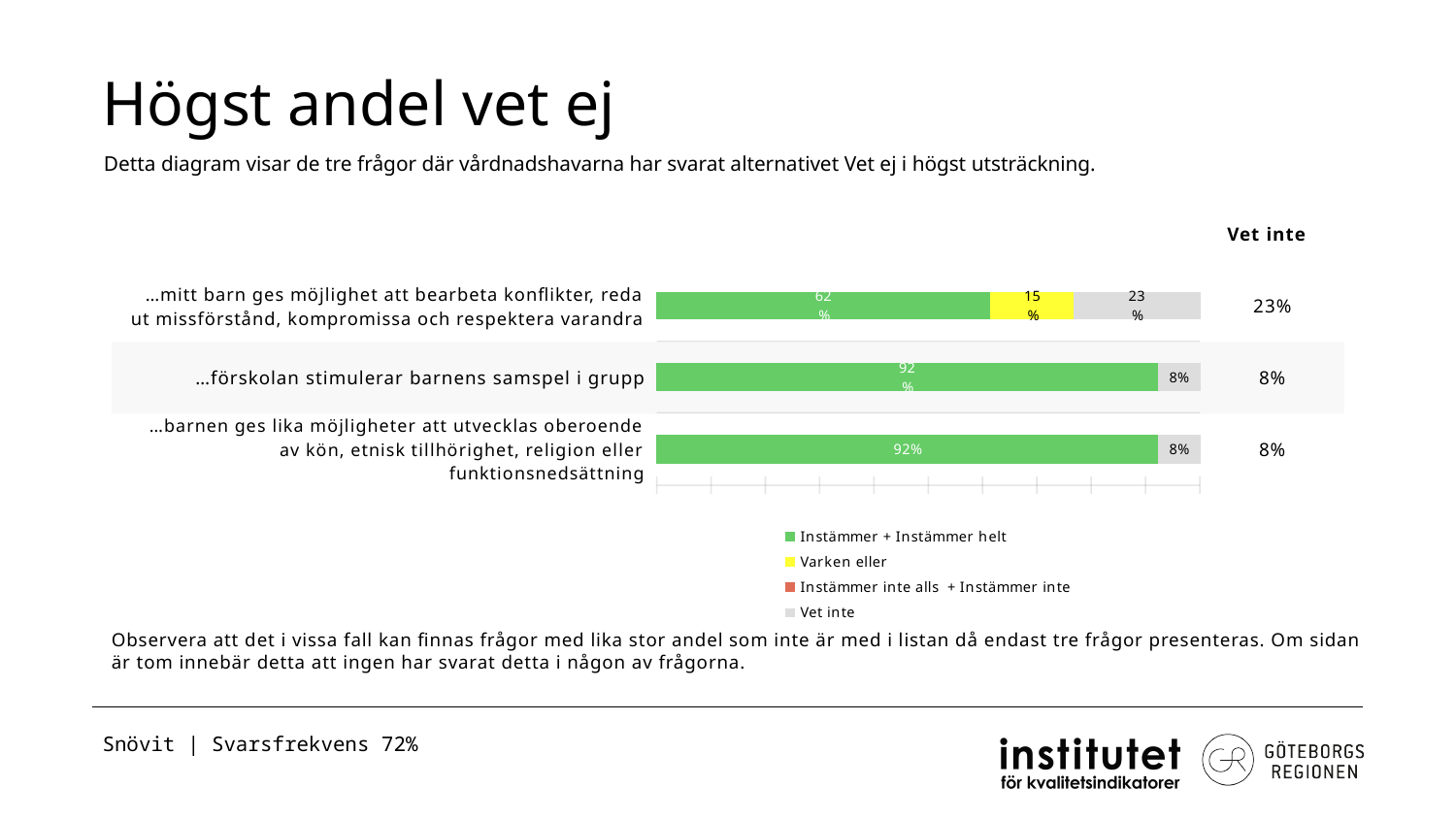
What is the title of the slide containing the chart? Högst andel vet ej How many categories (questions) are plotted in the chart? 3 Which is larger: the 'Instämmer + Instämmer helt' value for '…förskolan stimulerar barnens samspel i grupp' or for '…mitt barn ges möjlighet att bearbeta konflikter…'? …förskolan stimulerar barnens samspel i grupp What is the 'Varken eller' value for '…mitt barn ges möjlighet att bearbeta konflikter, reda ut missförstånd, kompromissa och respektera varandra'? 15% Which category has the lowest 'Instämmer + Instämmer helt' share? …mitt barn ges möjlighet att bearbeta konflikter, reda ut missförstånd, kompromissa och respektera varandra What kind of chart is shown on the slide? stacked bar chart Which category has the highest 'Vet inte' share? …mitt barn ges möjlighet att bearbeta konflikter, reda ut missförstånd, kompromissa och respektera varandra What is the difference between the 'Vet inte' value for '…mitt barn ges möjlighet att bearbeta konflikter…' and the 'Vet inte' value for '…förskolan stimulerar barnens samspel i grupp'? 15% What is the 'Vet inte' value for '…förskolan stimulerar barnens samspel i grupp'? 8% What is the 'Instämmer + Instämmer helt' value for '…barnen ges lika möjligheter att utvecklas oberoende av kön, etnisk tillhörighet, religion eller funktionsnedsättning'? 92% How many series does the legend list? 4 What is the 'Instämmer + Instämmer helt' value for '…mitt barn ges möjlighet att bearbeta konflikter, reda ut missförstånd, kompromissa och respektera varandra'? 62%